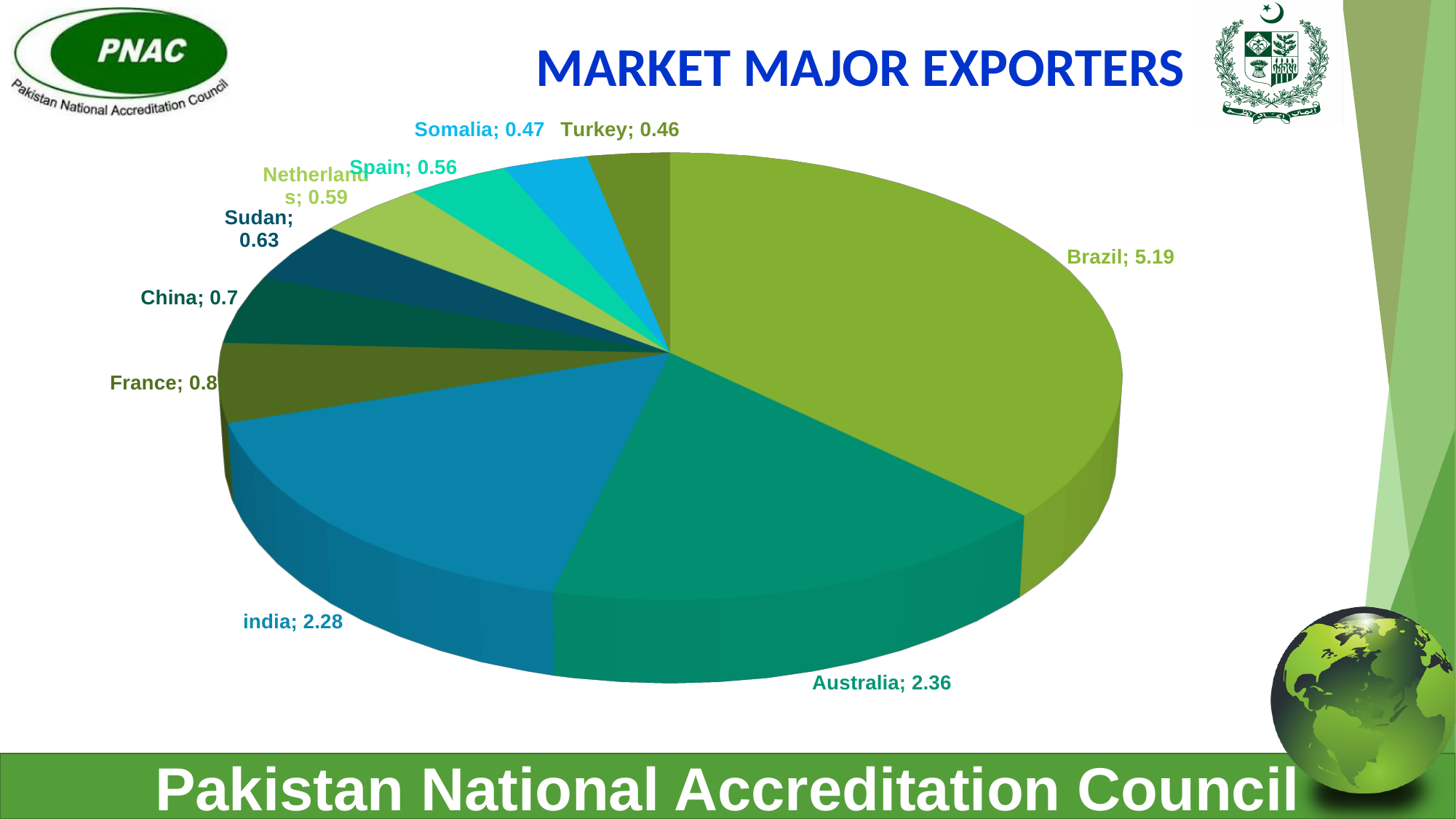
What is the value shown for Brazil? 5.19 What is the difference between the values for France and China? 0.1 Which country has the largest slice of the pie? Brazil Which has the larger value, Australia or india? Australia Which country has the smallest value in the chart? Turkey What type of chart is shown on the slide? Pie chart What is the value shown for Netherlands? 0.59 What is the title of the chart? MARKET MAJOR EXPORTERS What is the value shown for Sudan? 0.63 What is the difference between the values for Brazil and Australia? 2.83 How many countries are shown in the pie chart? 10 What is the value shown for Australia? 2.36